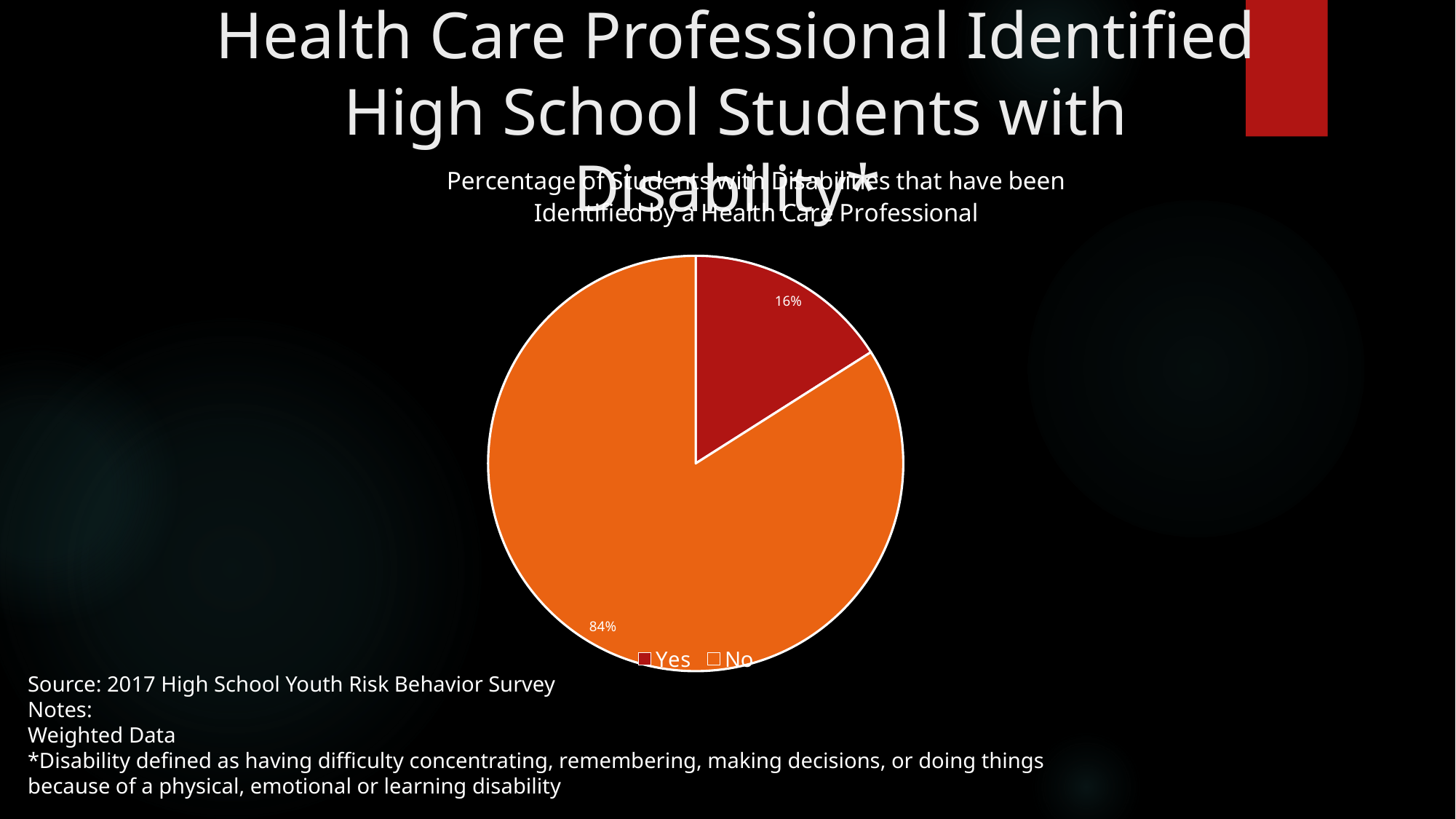
What is the source cited for the chart data? 2017 High School Youth Risk Behavior Survey Which slice is the smallest? Yes What is the difference in percentage points between the "No" slice and the "Yes" slice? 68 What percentage of students with disabilities have been identified by a health care professional (the "Yes" slice)? 16% What type of chart is shown on the slide? pie chart Which is larger, the "Yes" slice or the "No" slice? No How many slices does the pie chart have? 2 Which slice is the largest? No What colour is the "No" slice? orange How many entries does the legend list? 2 What percentage is shown for the "No" slice? 84% What share of the pie does the "Yes" slice represent? 16%